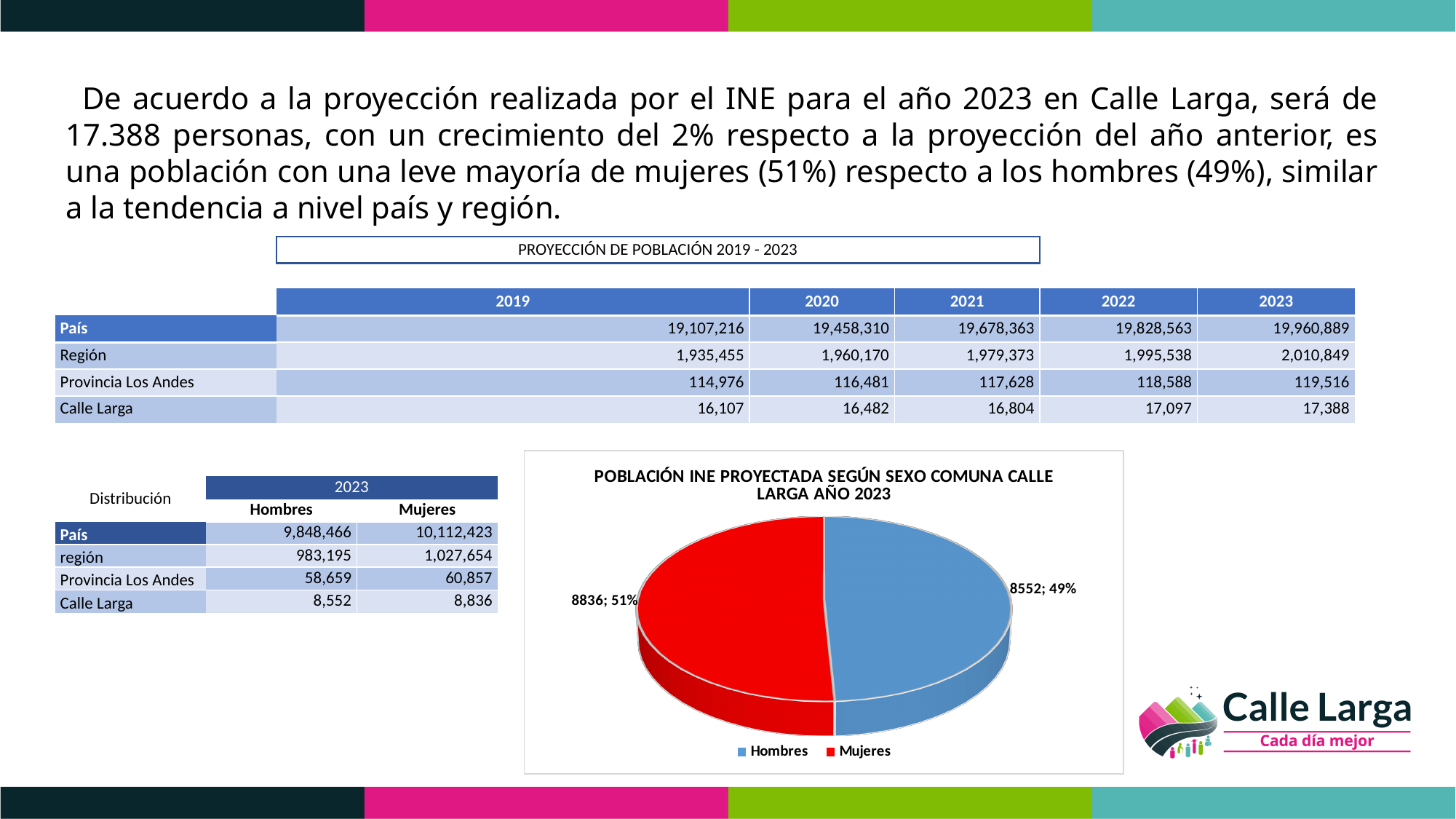
What kind of chart is shown on the slide? Pie chart How many slices does the pie chart have? 2 Which slice of the pie chart is the smallest? Hombres What is the title of the pie chart? POBLACIÓN INE PROYECTADA SEGÚN SEXO COMUNA CALLE LARGA AÑO 2023 In the pie chart, what is the difference between the Mujeres value and the Hombres value? 284 In the pie chart, what is the value for Hombres? 8552 In the pie chart, what share of the pie does Mujeres represent? 51% In the pie chart, what share of the pie does Hombres represent? 49% In the pie chart, what is the value for Mujeres? 8836 Which slice of the pie chart is the largest? Mujeres In the pie chart, which is larger, Hombres or Mujeres? Mujeres In the pie chart, what colour is the Mujeres slice? Red